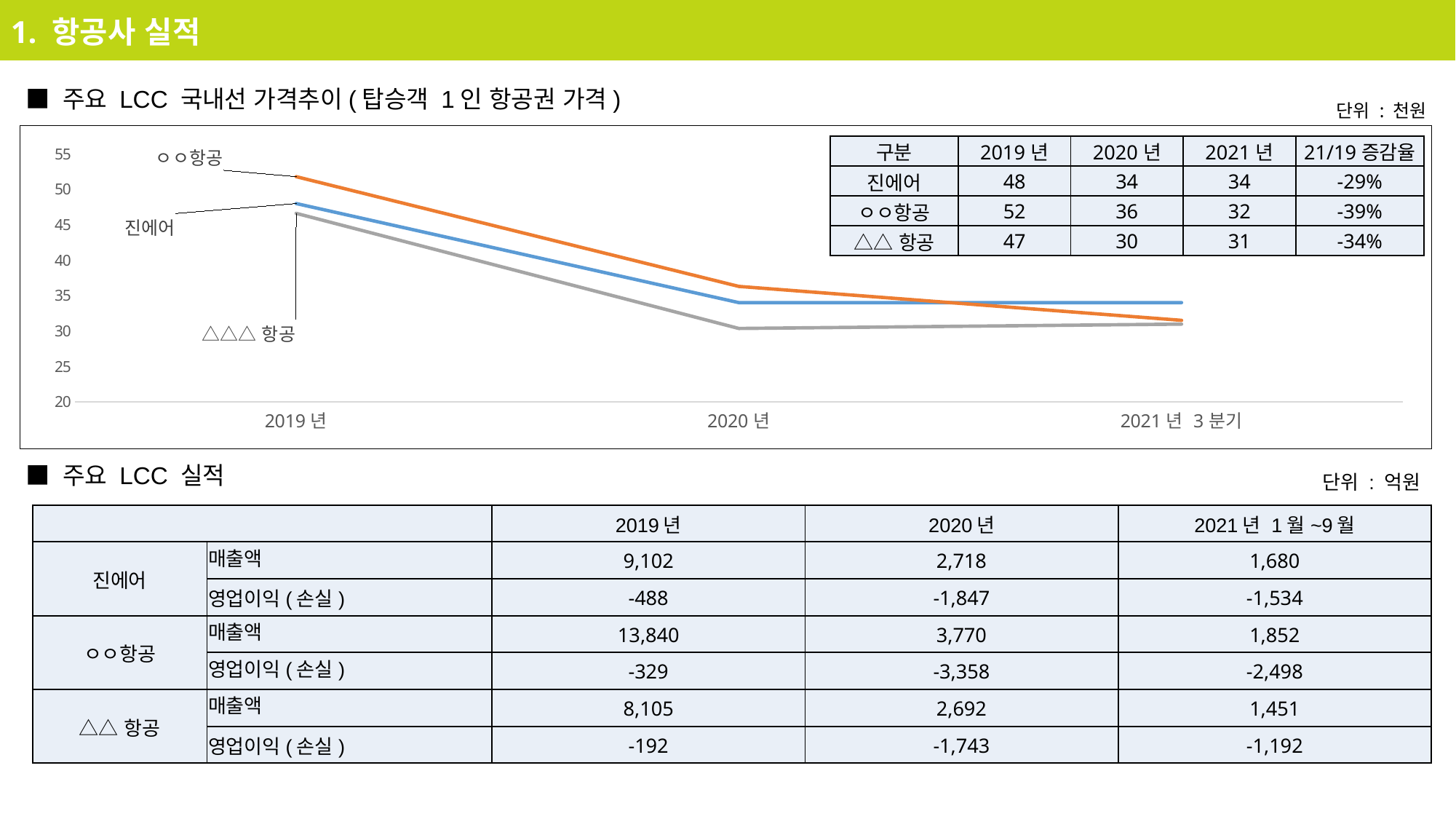
According to the table in the chart, what was the 2020년 price for △△ 항공? 30 How many points along the x axis does the line chart have? 3 What kind of chart is shown under the heading 주요 LCC 국내선 가격추이? line chart In 2019년, which was higher: the price for 진에어 or for △△ 항공? 진에어 Which airline had the highest price in 2019년? ㅇㅇ항공 According to the table in the chart, what was the 2021년 price for 진에어? 34 Does the price for ㅇㅇ항공 rise or fall from 2019년 to 2021년 3분기? fall How many series are plotted in the line chart? 3 Which airline had the lowest price in 2020년? △△ 항공 According to the table in the chart, what was the 2019년 price for ㅇㅇ항공? 52 What is the difference between the 2019년 and 2021년 prices for ㅇㅇ항공? 20 What is the 21/19 증감율 shown for △△ 항공 in the chart's table? -34%